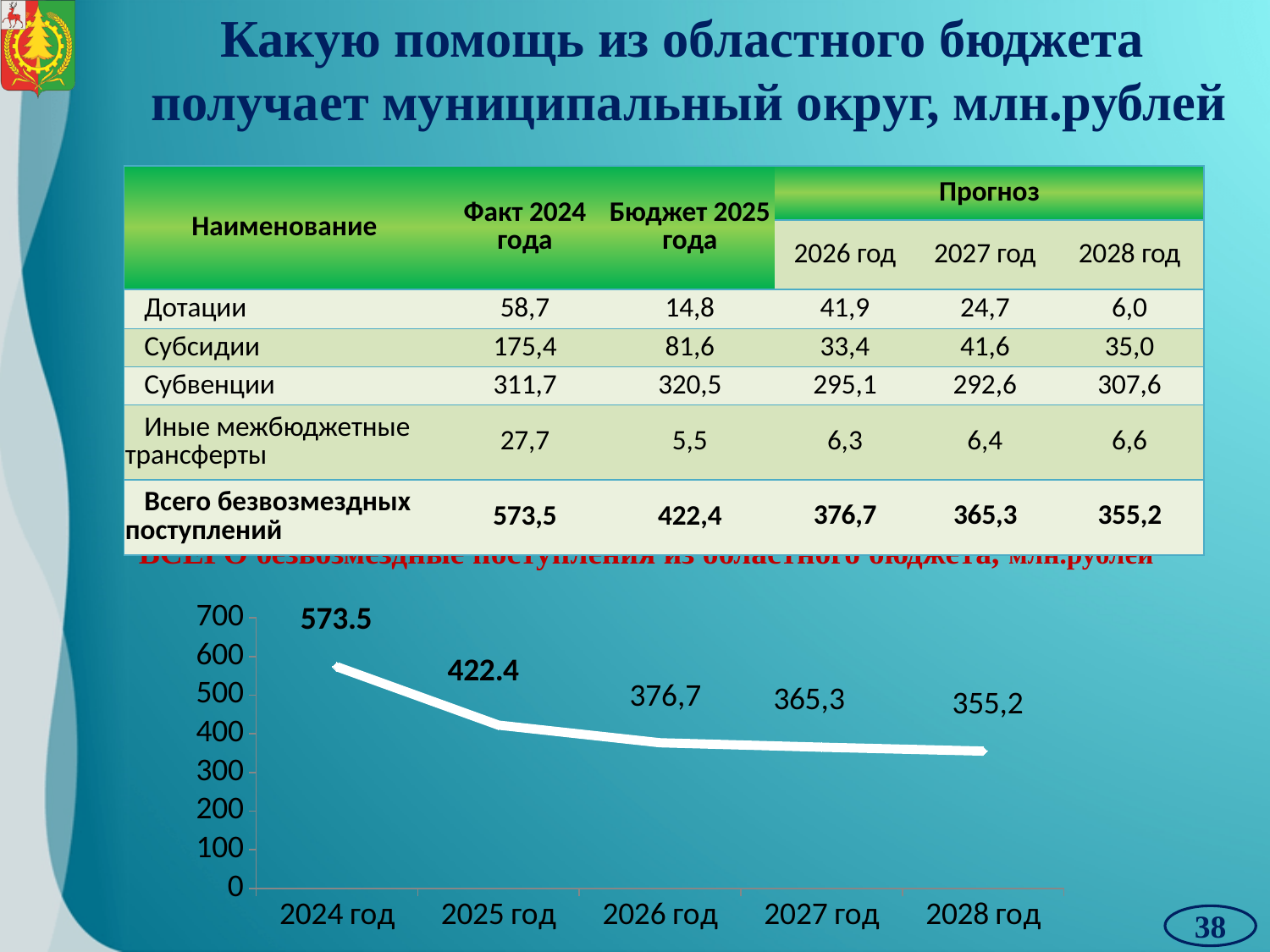
Is the value for 2025 год on the line chart greater or less than 400? greater Which is larger on the line chart, the value for 2026 год or for 2027 год? 2026 год What is the difference between the values for 2027 год and 2028 год on the line chart? 10,1 What is the value for 2026 год on the line chart? 376,7 What is the value for 2027 год on the line chart? 365,3 Which year has the highest value on the line chart? 2024 год What is the value for 2028 год on the line chart? 355,2 How many years are plotted on the line chart? 5 What is the difference between the values for 2024 год and 2025 год on the line chart? 151.1 What is the value for 2024 год on the line chart? 573.5 Which year has the lowest value on the line chart? 2028 год Do the values on the line chart rise or fall from 2024 год to 2028 год? fall